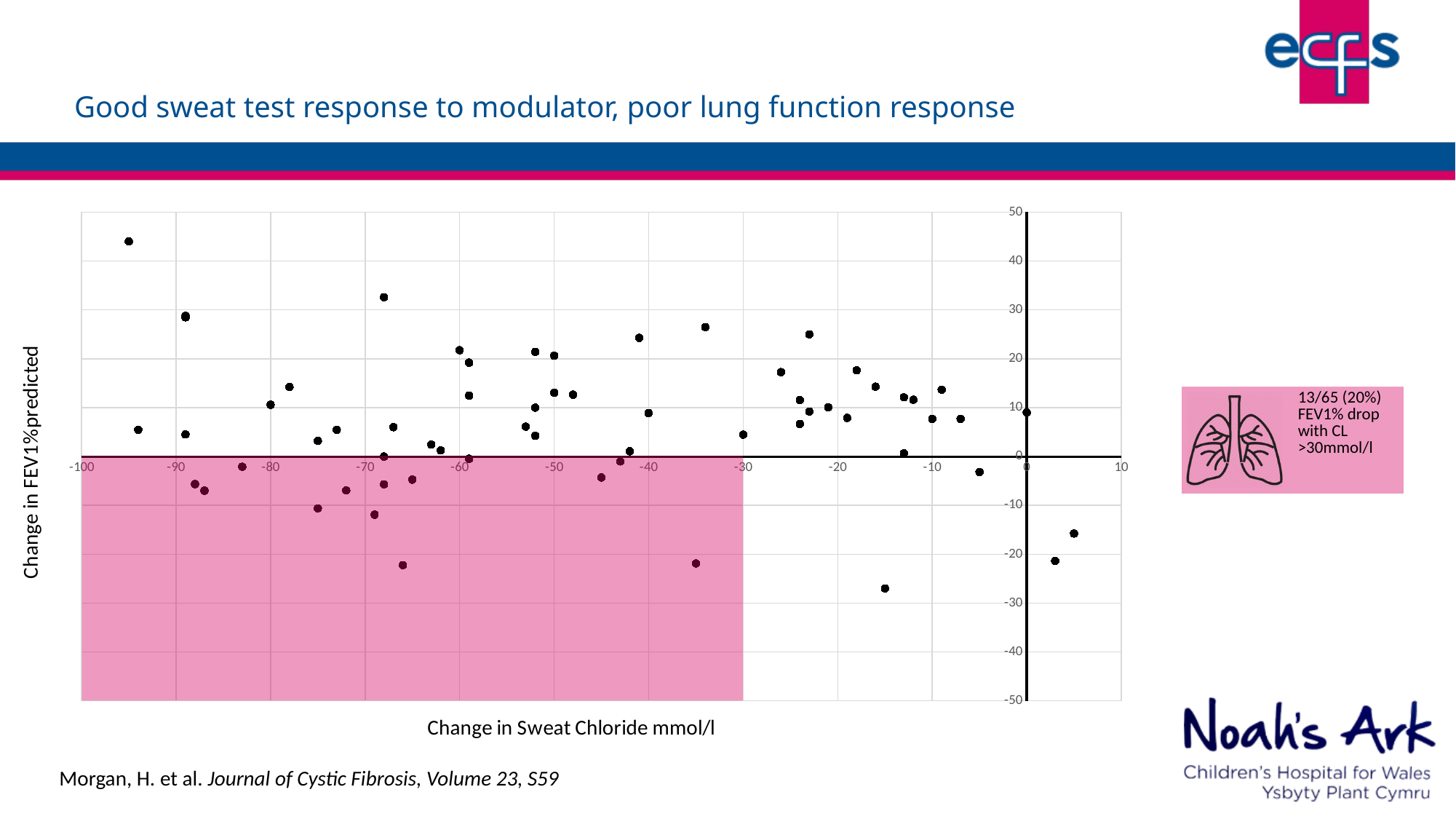
Is the Change in FEV1%predicted of the lowest plotted point greater or less than -20? less What does the pink annotation box to the right of the chart say? 13/65 (20%) FEV1% drop with CL >30mmol/l Is the Change in FEV1%predicted of the highest plotted point greater or less than 40? greater What kind of chart is shown on the slide? scatter chart Is the Change in FEV1%predicted of the leftmost plotted point (near -95 mmol/l) greater or less than 0? greater What is the title of the x axis of the chart? Change in Sweat Chloride mmol/l